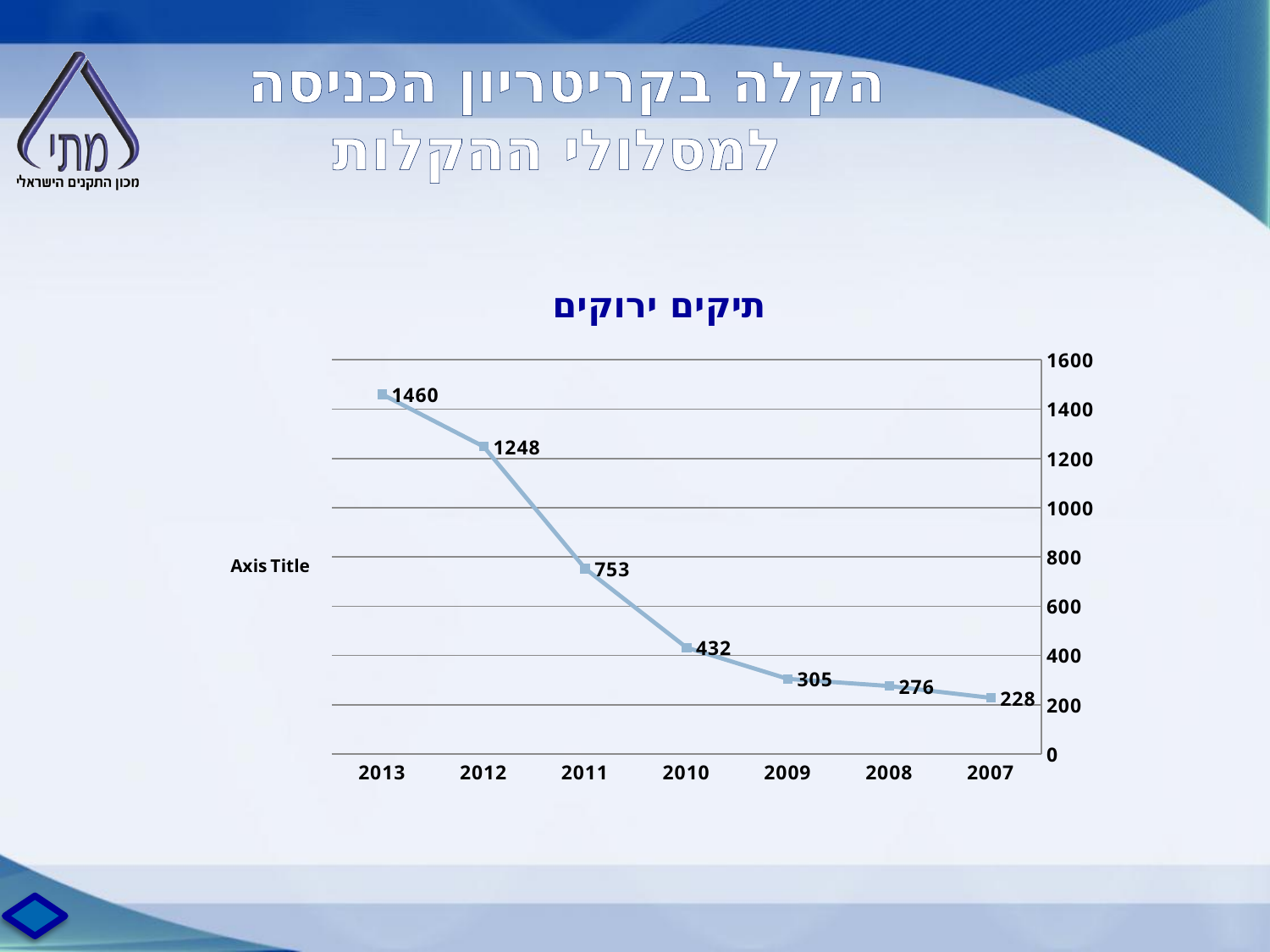
Which is larger, the value for 2009 or the value for 2008? 2009 Which year has the lowest value? 2007 What is the value for 2010? 432 Do the values rise or fall moving from left (2013) to right (2007) along the x axis? fall What is the difference between the values for 2013 and 2012? 212 What is the value for 2013? 1460 What is the value for 2007? 228 Is the value for 2011 greater or less than 800? less Which year has the highest value? 2013 What is the difference between the values for 2011 and 2010? 321 What kind of chart is shown on the slide? line chart How many years are plotted on the x axis? 7